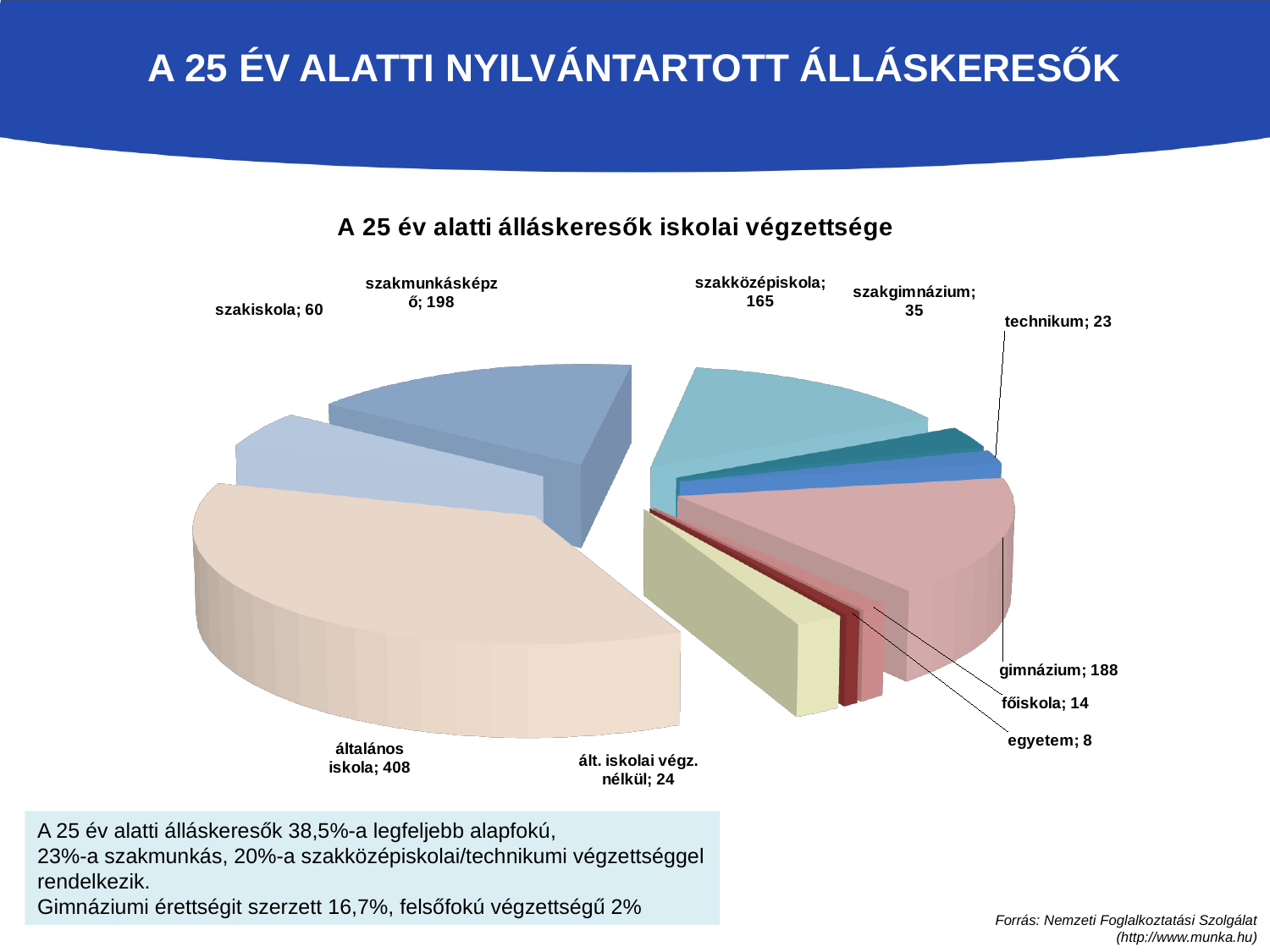
What is the value for technikum? 23 Which category has the lowest value? egyetem What is the value for általános iskola? 408 Which category has the highest value? általános iskola What is the title of the chart? A 25 év alatti álláskeresők iskolai végzettsége What is the difference between the values for szakmunkásképző and gimnázium? 10 What is the difference between the values for szakiskola and szakgimnázium? 25 Which is larger, the value for szakközépiskola or the value for gimnázium? gimnázium What kind of chart is shown on the slide? pie chart What is the value for ált. iskolai végz. nélkül? 24 How many categories (slices) does the pie chart have? 10 What is the value for szakmunkásképző? 198